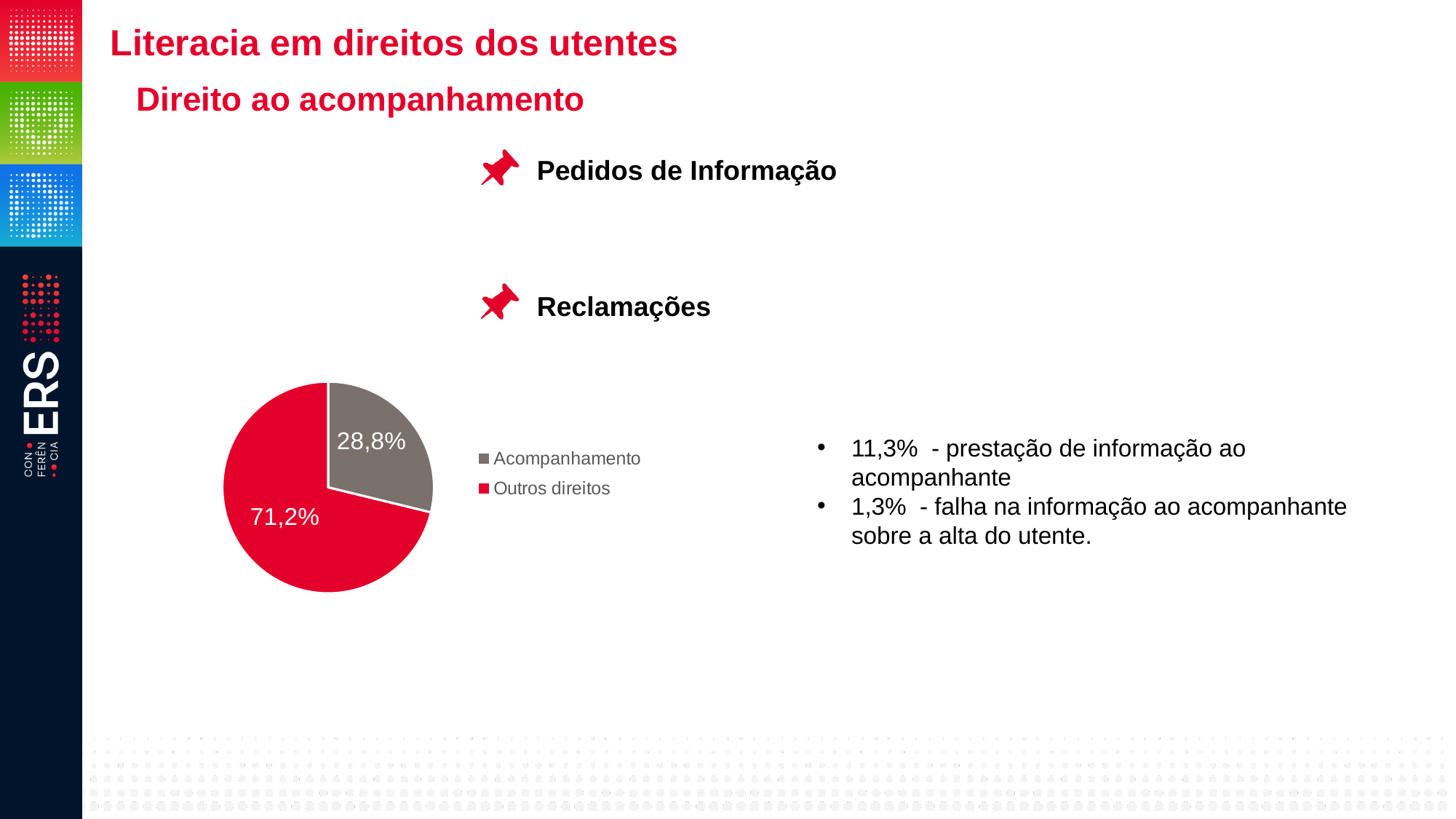
Which slice of the pie is the smallest? Acompanhamento What share of the pie does Outros direitos represent? 71,2% What colour is the Acompanhamento slice in the pie chart? grey How many entries does the legend of the pie chart list? 2 What share of the pie does Acompanhamento represent? 28,8% What kind of chart is shown on the slide? pie chart What colour is the Outros direitos slice in the pie chart? red Which is larger, the share for Acompanhamento or the share for Outros direitos? Outros direitos How many slices does the pie chart have? 2 What is the difference in percentage points between Outros direitos and Acompanhamento? 42,4 Which slice of the pie is the largest? Outros direitos